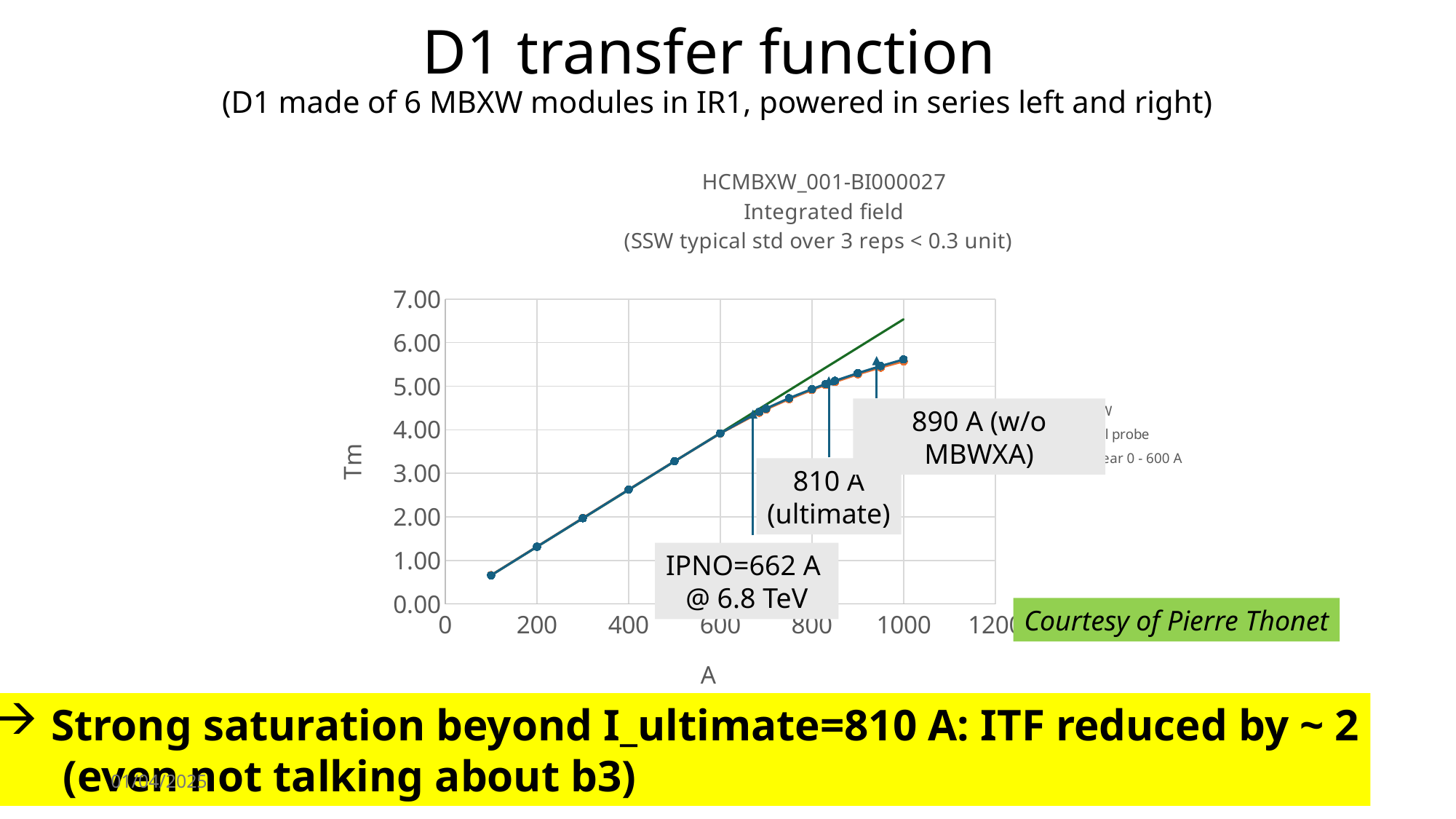
Which has the larger plotted value, 800 A or 400 A? 800 A Do the plotted values rise or fall as the current (A) increases along the x axis? rise What is the label of the x axis of the chart? A Which plotted current has the lowest integrated field value? 100 A What current is marked on the chart as the ultimate current? 810 A Is the plotted value at 400 A greater or less than 3.00 Tm? less Which plotted current has the highest integrated field value? 1000 A What kind of chart is shown on the slide? line chart What is the label of the y axis of the chart? Tm Is the plotted value at 600 A greater or less than 3.00 Tm? greater Is the plotted value at 100 A greater or less than 1.00 Tm? less